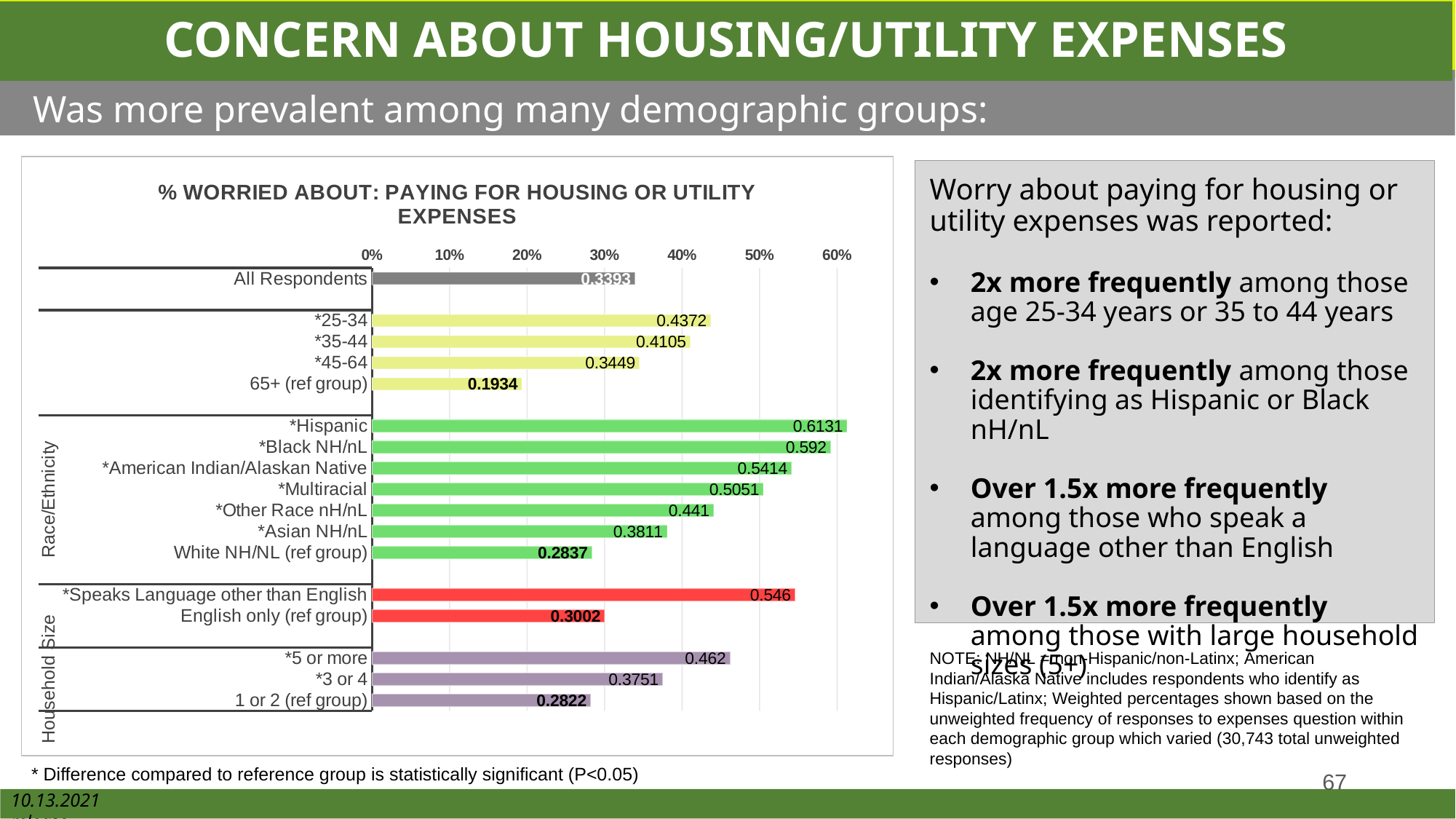
What is the value for 65+ (ref group) in the chart? 0.1934 What is the difference between the values for *5 or more and 1 or 2 (ref group)? 0.1798 Which category has the highest value in the chart? *Hispanic Is the value for *5 or more greater or less than 40%? greater What is the value for *Hispanic in the chart? 0.6131 What is the difference between the values for *Hispanic and White NH/NL (ref group)? 0.3294 Which category has the lowest value in the chart? 65+ (ref group) What type of chart is shown on the slide? Bar chart What is the value for All Respondents in the chart? 0.3393 How many bars are plotted in the chart? 17 Which has a larger value, *25-34 or *35-44? *25-34 What is the value for *Speaks Language other than English? 0.546